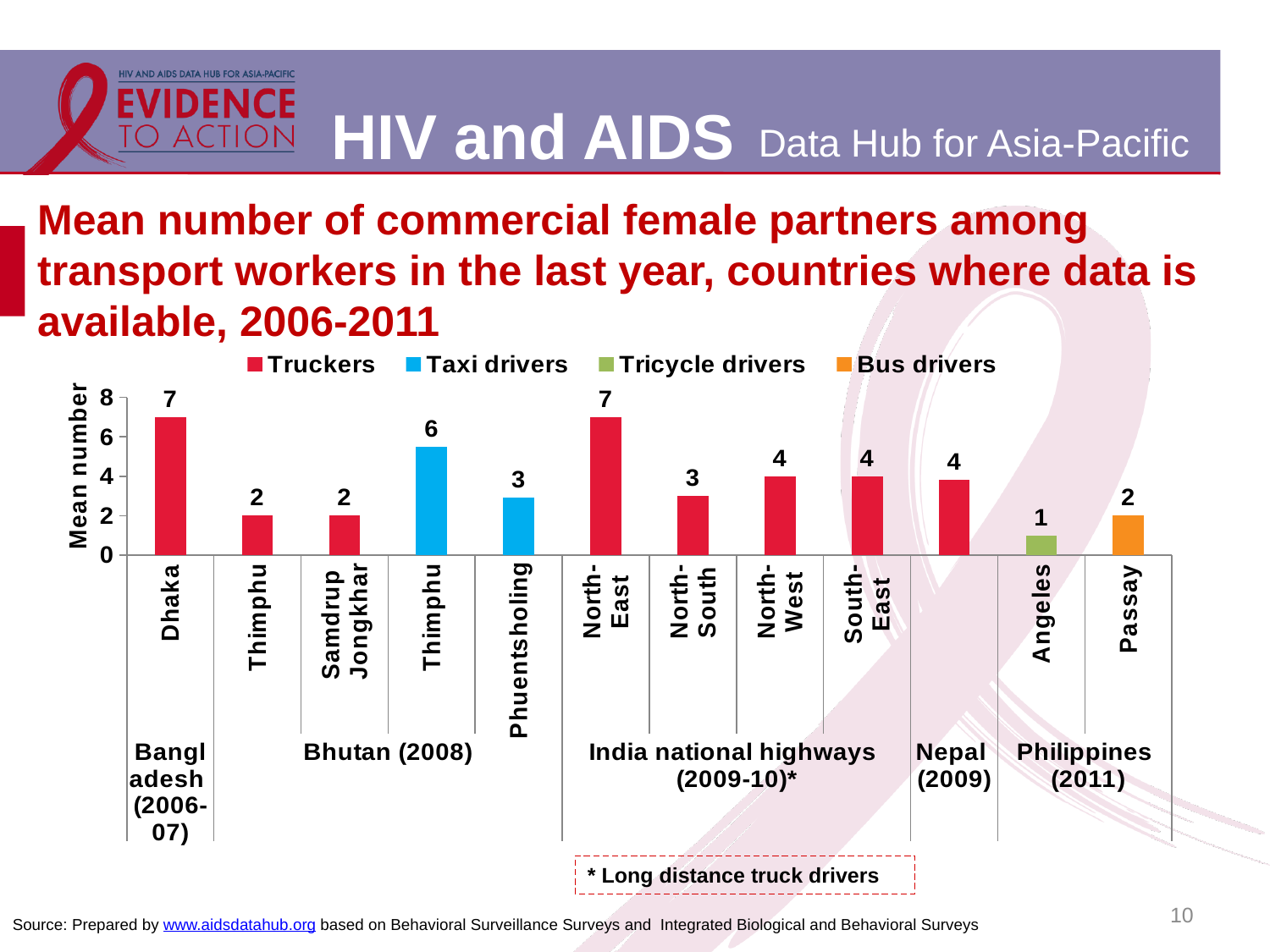
Which location has the lowest mean number of commercial female partners? Angeles What is the mean number of commercial female partners among truckers in Dhaka? 7 What is the mean number for tricycle drivers in Angeles, Philippines? 1 In Thimphu, which group has the higher mean number: truckers or taxi drivers? Taxi drivers What is the mean number for truckers on the North-West national highway in India? 4 What is the mean number for truckers in Nepal (2009)? 4 How many series does the legend list? 4 What is the mean number for bus drivers in Passay? 2 What is the difference between the mean number for truckers on the North-East and North-South highways in India? 4 What is the mean number for taxi drivers in Phuentsholing? 3 What is the difference between the mean number for truckers in Dhaka and tricycle drivers in Angeles? 6 What type of chart is shown on the slide? Bar chart